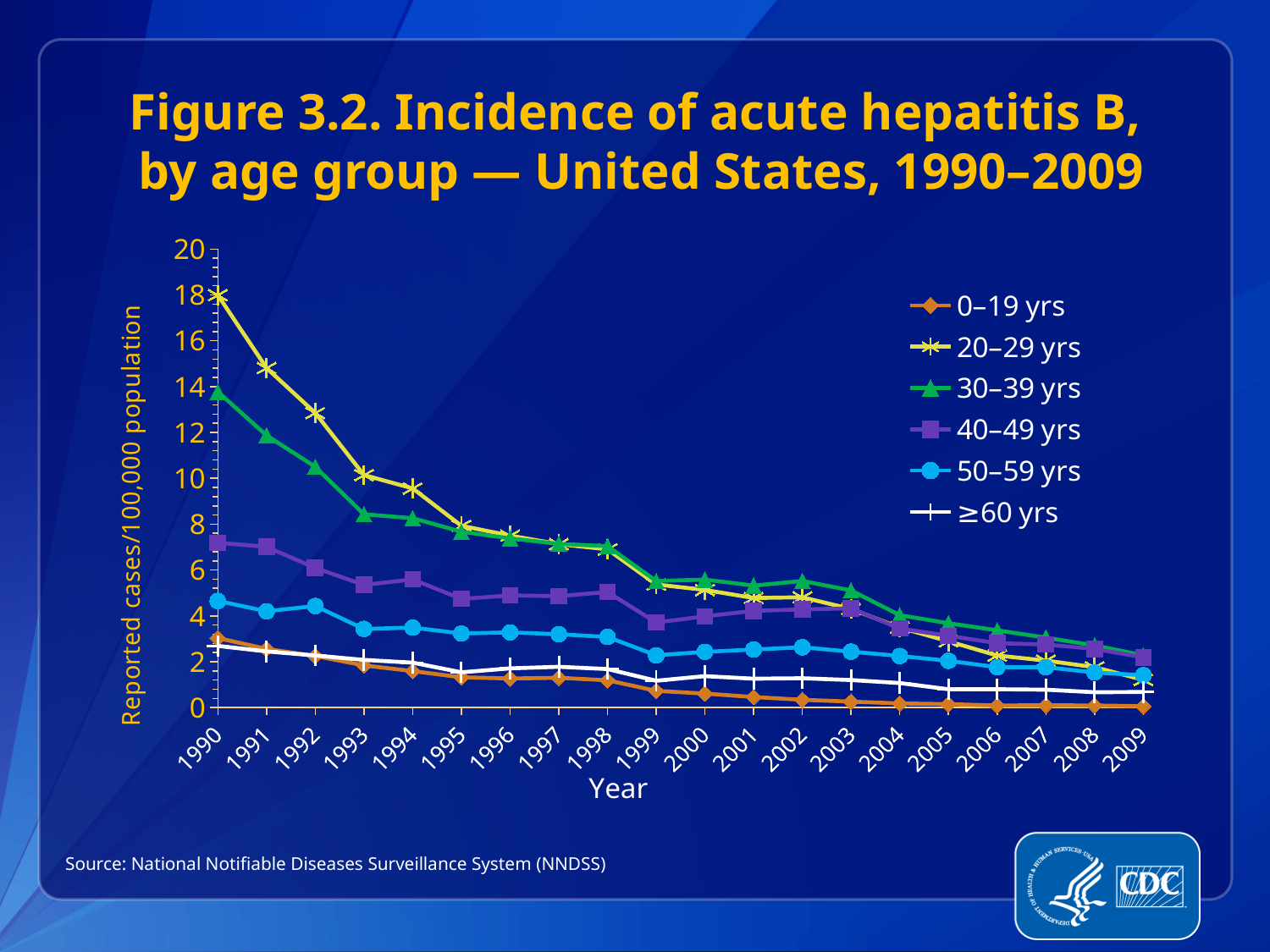
Which age group had the highest incidence in 1990? 20–29 yrs Which age group had the lowest incidence in 2009? 0–19 yrs In 1995, which had the higher incidence: 40–49 yrs or 50–59 yrs? 40–49 yrs How many age-group series does the legend list? 6 What kind of chart is shown on the slide? line chart Is the value for 30–39 yrs in 1990 greater or less than 12? greater How many years are plotted along the x axis? 20 Is the value for 20–29 yrs in 1990 greater or less than 16? greater In 2002, which had the higher incidence: 30–39 yrs or 50–59 yrs? 30–39 yrs What is the label on the y axis? Reported cases/100,000 population Does the incidence for 20–29 yrs rise or fall from 1990 to 2009? fall Is the value for 0–19 yrs in 2009 greater or less than 2? less